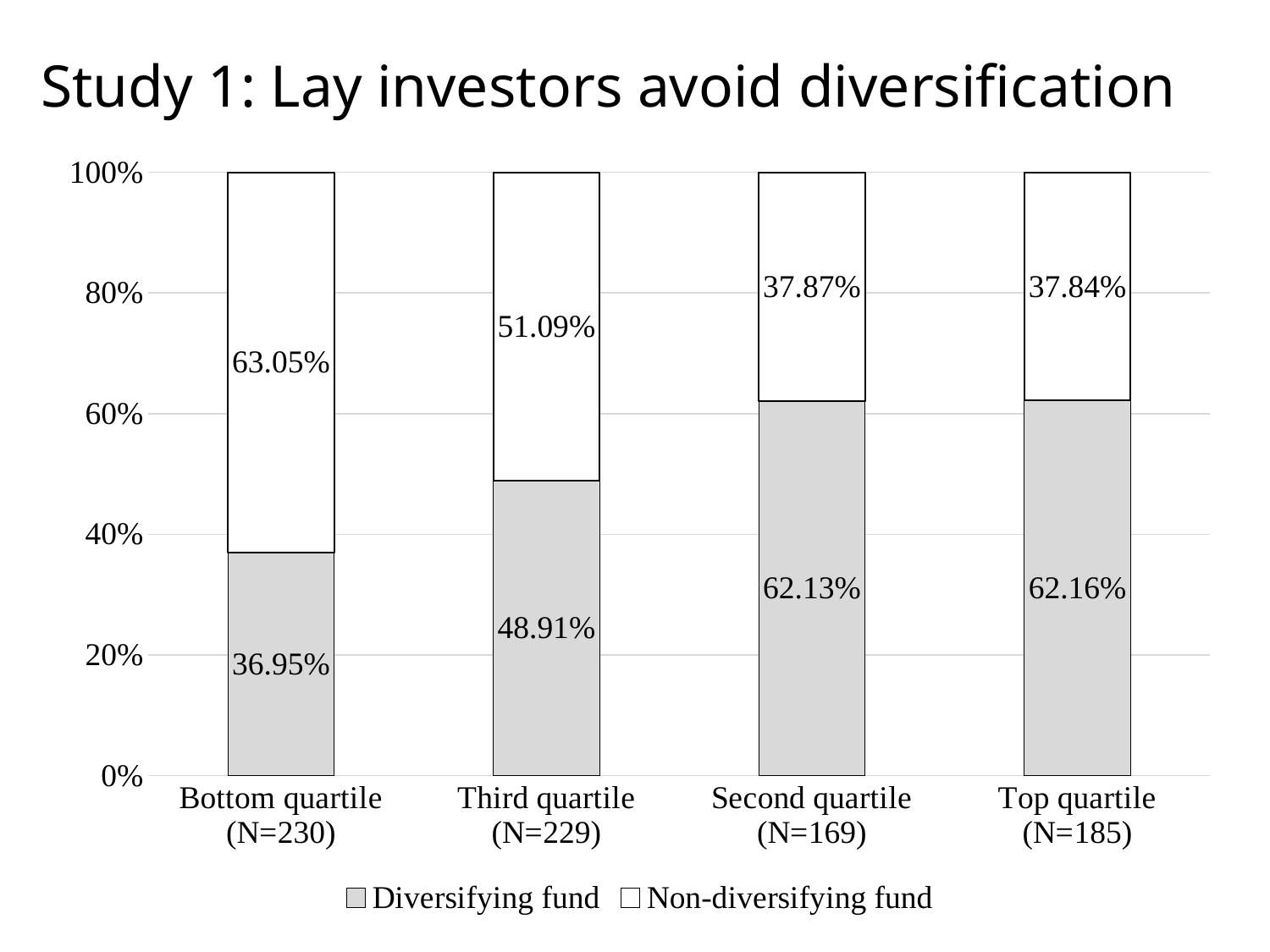
Does the Diversifying fund share rise or fall from the Bottom quartile to the Top quartile? rise Is the Diversifying fund value for the Top quartile (N=185) greater or less than 60%? greater What is the Diversifying fund value for the Second quartile (N=169)? 62.13% Is the Diversifying fund value larger for the Third quartile (N=229) or the Bottom quartile (N=230)? Third quartile (N=229) What is the Non-diversifying fund value for the Top quartile (N=185)? 37.84% How many quartile categories are shown on the x axis? 4 How many series does the legend list? 2 What is the Diversifying fund value for the Bottom quartile (N=230)? 36.95% What is the difference between the Non-diversifying fund and Diversifying fund values for the Bottom quartile (N=230)? 26.10% What is the Non-diversifying fund value for the Third quartile (N=229)? 51.09% Which quartile has the highest Non-diversifying fund value? Bottom quartile (N=230) Which quartile has the lowest Diversifying fund value? Bottom quartile (N=230)